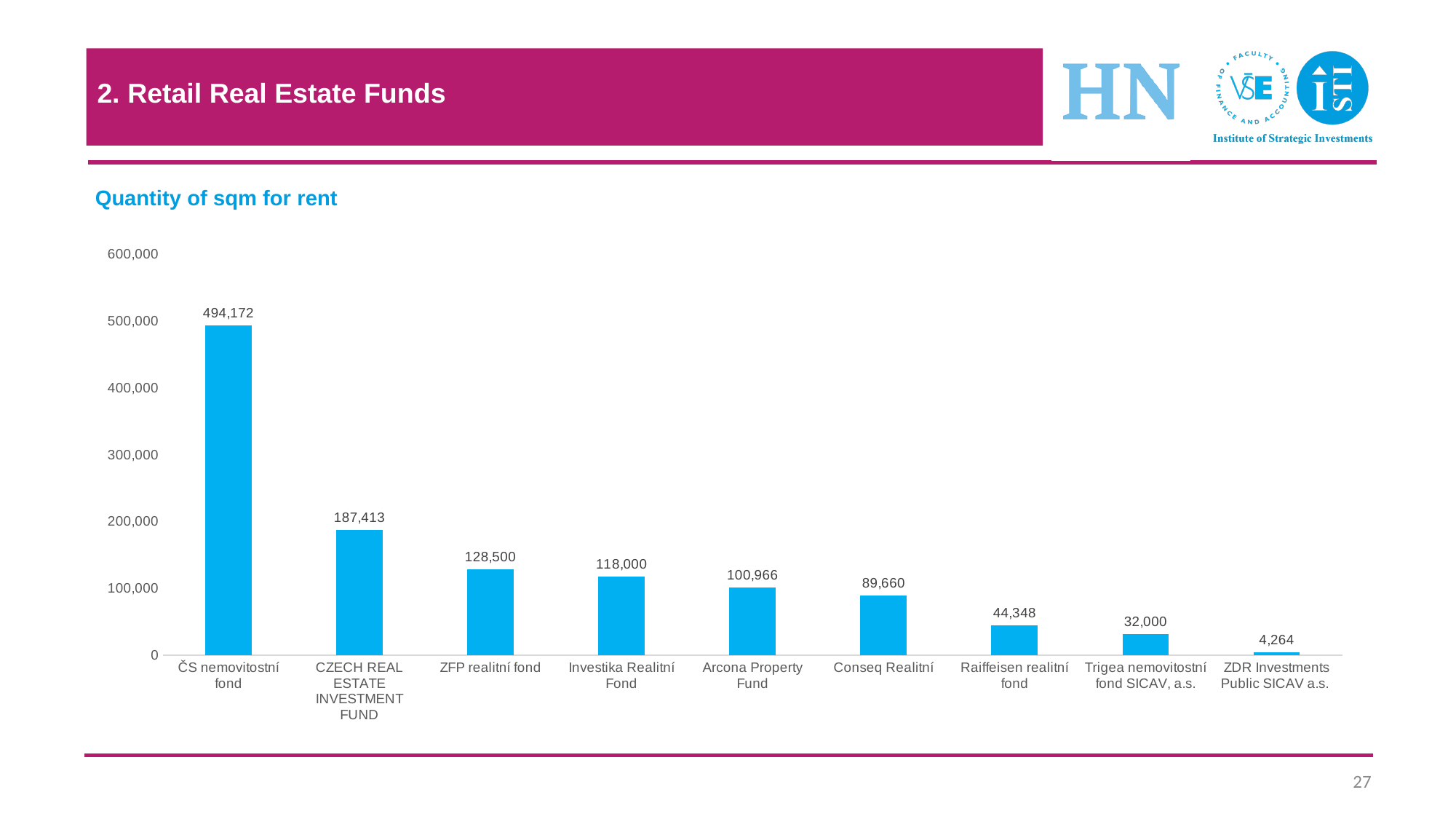
Is the value for Raiffeisen realitní fond greater or less than 100,000? less What is the quantity of sqm for rent for Investika Realitní Fond? 118,000 What kind of chart is shown on the slide? Bar chart What is the quantity of sqm for rent for Trigea nemovitostní fond SICAV, a.s.? 32,000 What is the difference in sqm for rent between ZFP realitní fond and Investika Realitní Fond? 10,500 Do the values rise or fall from left to right along the x axis? Fall Which fund has the lowest quantity of sqm for rent? ZDR Investments Public SICAV a.s. What is the difference in sqm for rent between ČS nemovitostní fond and CZECH REAL ESTATE INVESTMENT FUND? 306,759 Which has more sqm for rent, Arcona Property Fund or Conseq Realitní? Arcona Property Fund How many funds are shown in the chart? 9 Which fund has the highest quantity of sqm for rent? ČS nemovitostní fond What is the quantity of sqm for rent for ČS nemovitostní fond? 494,172